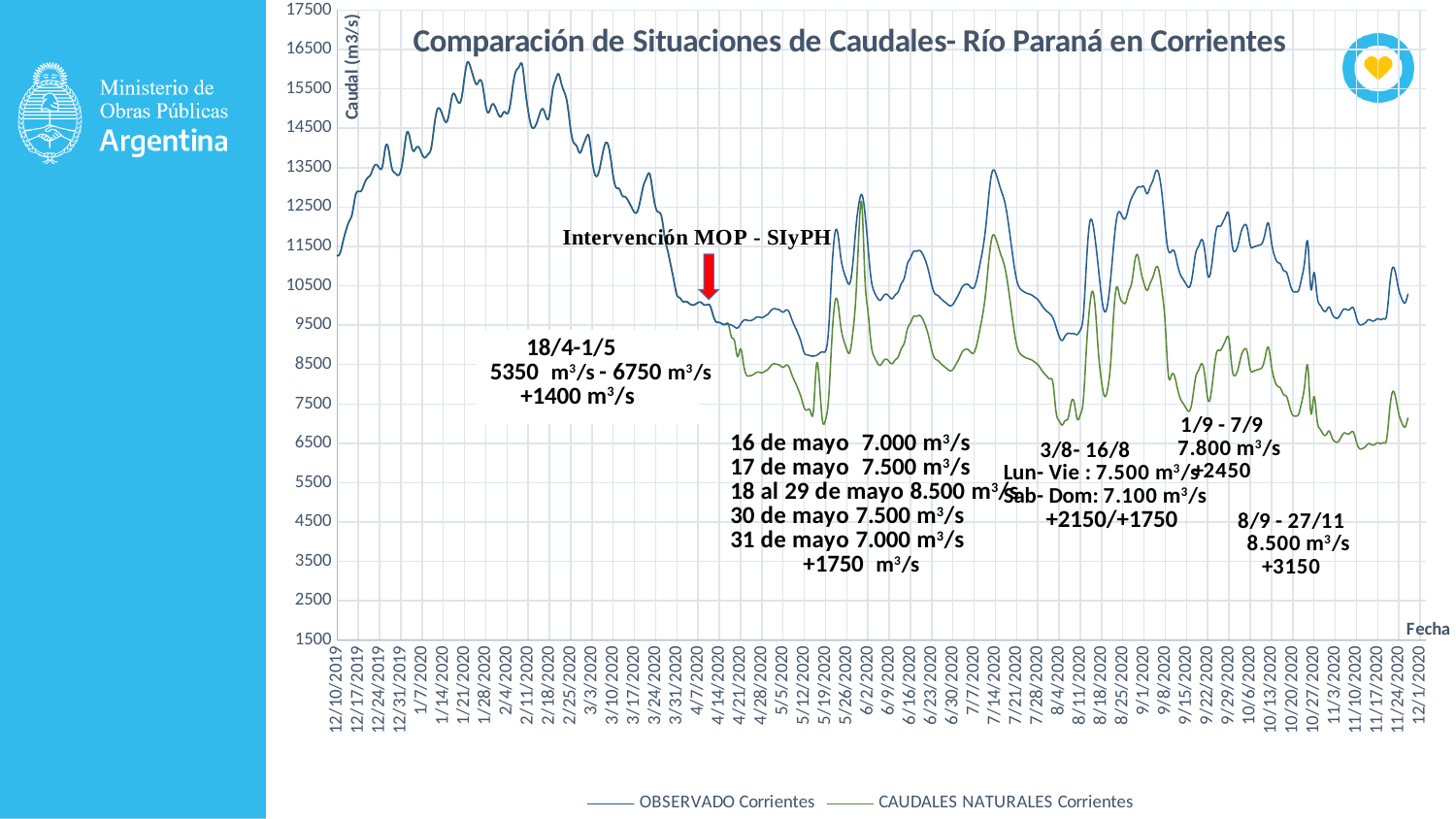
Is the OBSERVADO Corrientes value at 12/10/2019 greater or less than 10500? greater What are the two series named in the legend? OBSERVADO Corrientes and CAUDALES NATURALES Corrientes What kind of chart is shown on the slide? line chart Does the OBSERVADO Corrientes series rise or fall between 2/11/2020 and 4/14/2020? fall What is the title of the chart? Comparación de Situaciones de Caudales- Río Paraná en Corrientes Is the CAUDALES NATURALES Corrientes value around 8/4/2020 greater or less than 8500? less Is the OBSERVADO Corrientes value around 1/21/2020 greater or less than 15500? greater Which series has the higher value around 7/14/2020, OBSERVADO Corrientes or CAUDALES NATURALES Corrientes? OBSERVADO Corrientes How many series does the legend list? 2 Does the OBSERVADO Corrientes series rise or fall between 12/10/2019 and 1/21/2020? rise